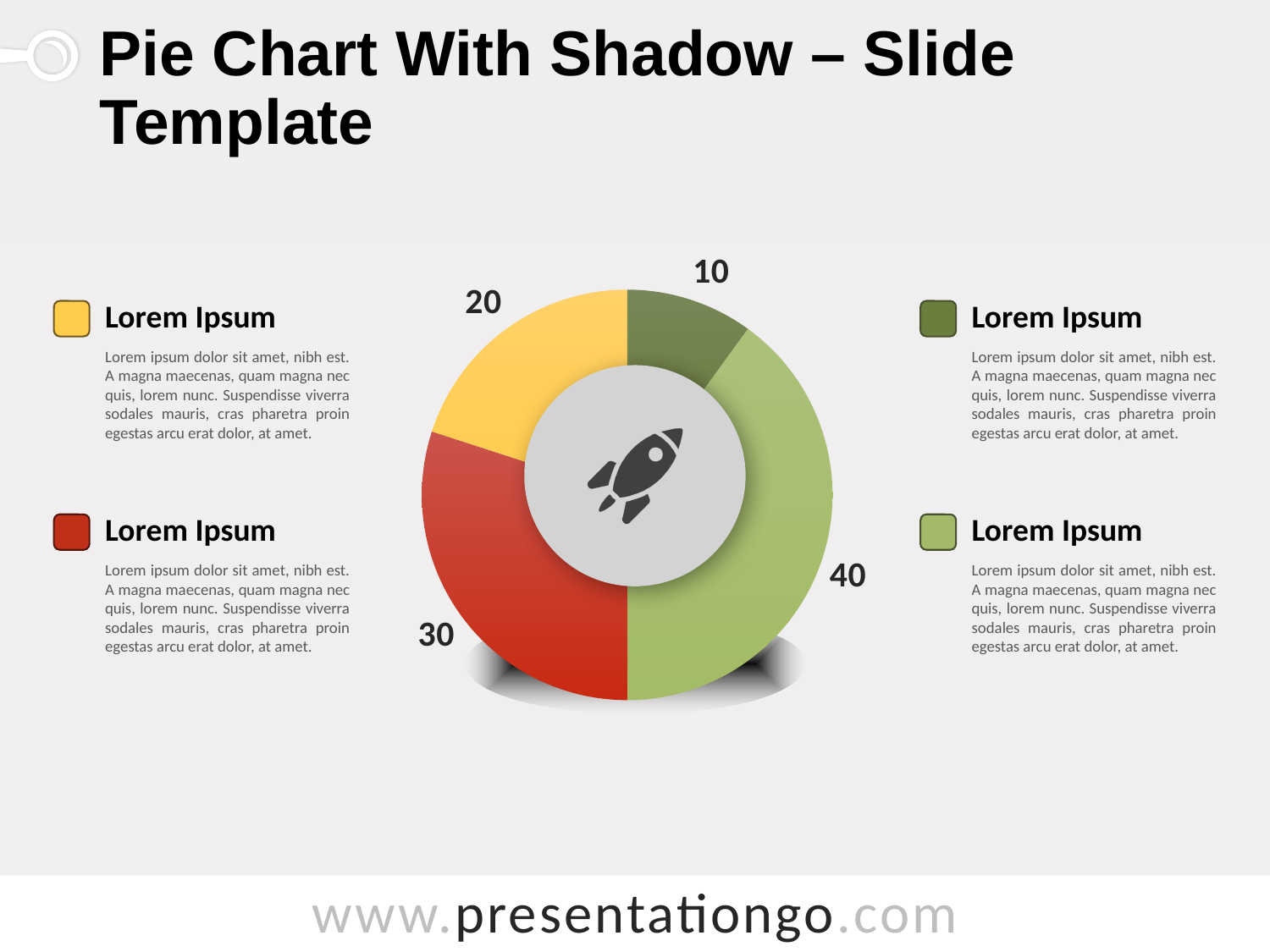
What is the value of the light green slice of the pie chart? 40 What is the total of all slice values in the pie chart? 100 What is the difference between the largest and smallest slice values in the pie chart? 30 What is the value of the red slice of the pie chart? 30 Which slice of the pie chart has the largest value? the light green slice (40) What kind of chart is shown on the slide? pie chart How many slices does the pie chart have? 4 Which is larger in the pie chart, the red slice or the yellow slice? the red slice Which slice of the pie chart has the smallest value? the dark green slice (10) What is the value of the dark green slice of the pie chart? 10 What share of the pie chart does the red slice represent? 30% What is the value of the yellow slice of the pie chart? 20